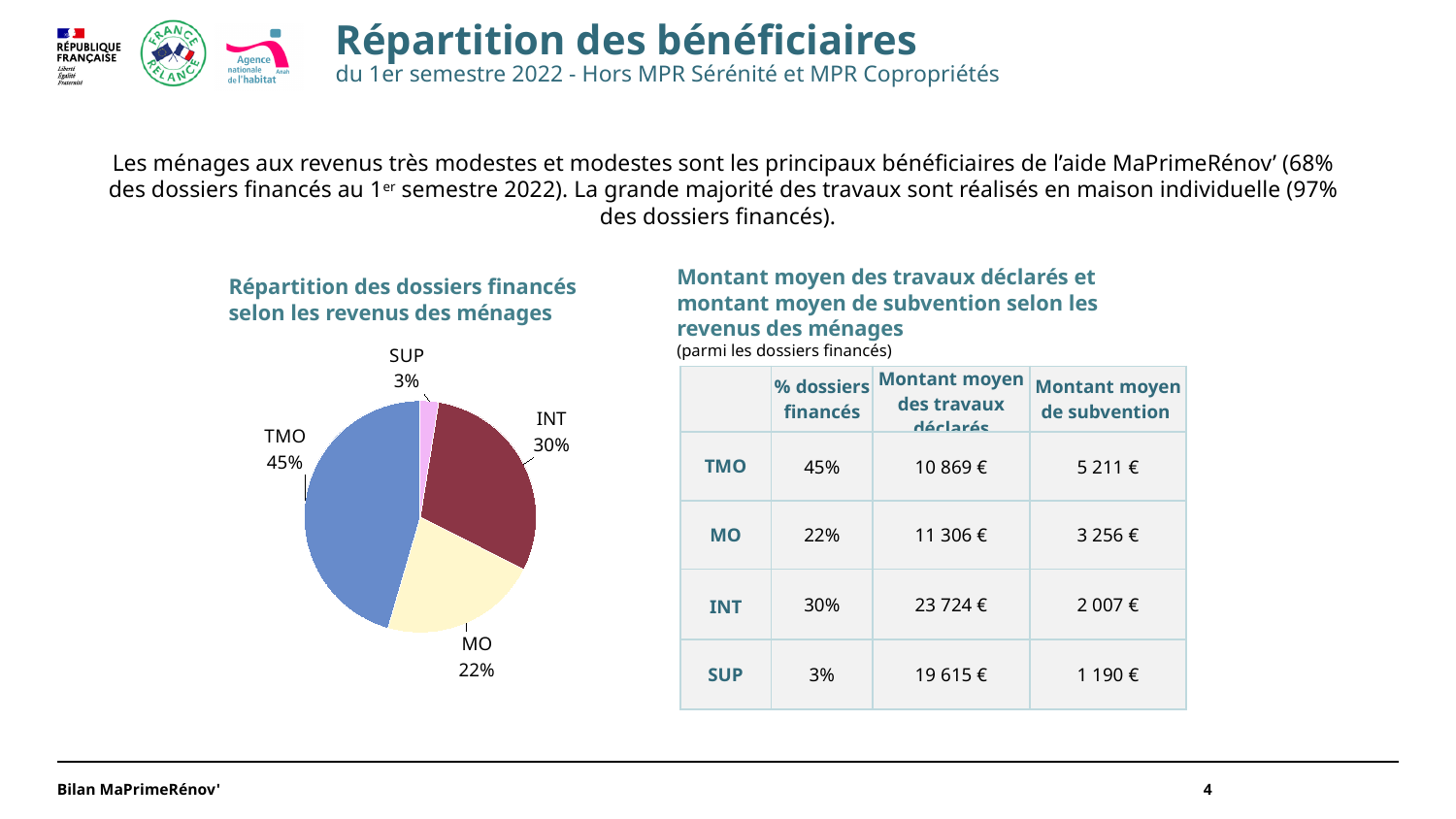
What is the share of INT in the pie chart? 30% How many slices does the pie chart have? 4 What is the share of MO in the pie chart? 22% What is the difference in percentage points between the TMO and INT slices? 15 What is the share of SUP in the pie chart? 3% What is the combined share of the TMO and MO slices? 67% What is the share of TMO in the pie chart? 45% Which category has the smallest slice in the pie chart? SUP Which category has the largest slice in the pie chart? TMO What type of chart is shown on the slide? pie chart Which slice is larger, INT or MO? INT What is the title of the pie chart? Répartition des dossiers financés selon les revenus des ménages